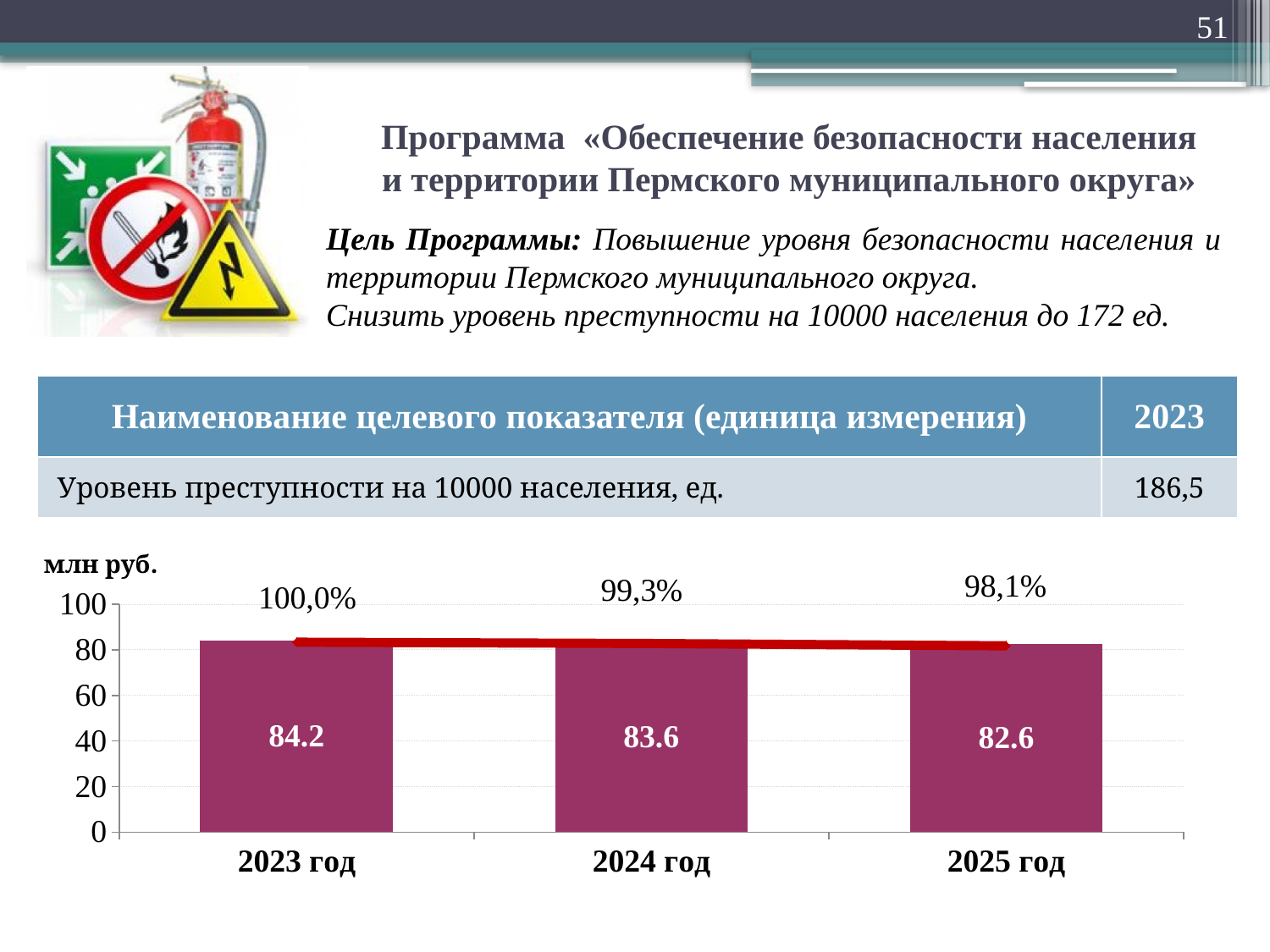
How many years are shown on the x axis of the chart? 3 What percentage label is shown above the 2025 год bar? 98,1% What is the value for 2023 год in the bar chart? 84.2 What is the value for 2024 год in the bar chart? 83.6 Is the value for 2024 год greater or less than 80? greater What is the value for 2025 год in the bar chart? 82.6 Which year has the lowest bar in the chart? 2025 год Which is larger, the value for 2024 год or the value for 2025 год? 2024 год Which year has the highest bar in the chart? 2023 год Do the bar values rise or fall from 2023 год to 2025 год? fall What is the difference between the values for 2023 год and 2025 год? 1.6 What kind of chart is shown on the slide? combination bar and line chart